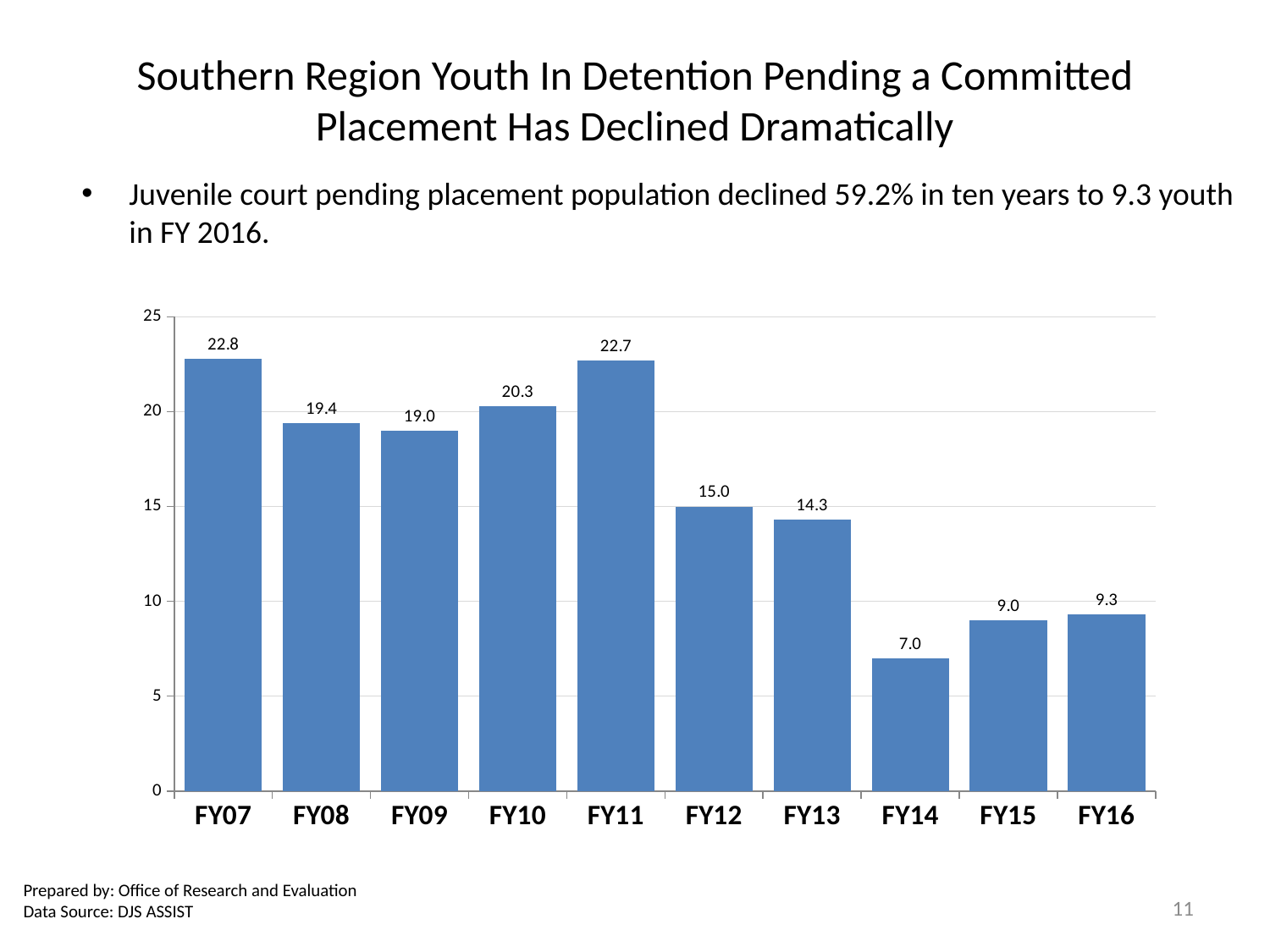
Is the value for FY13 greater or less than 15? less What is the difference between the values for FY11 and FY12? 7.7 Which fiscal year has the highest value? FY07 Do the values generally rise or fall from FY07 to FY16? fall What is the value for FY07? 22.8 How many fiscal years are shown on the x axis? 10 What is the difference between the values for FY07 and FY16? 13.5 Which fiscal year has the lowest value? FY14 What is the value for FY14? 7.0 What is the value for FY16? 9.3 Which is larger, the value for FY10 or the value for FY09? FY10 What kind of chart is shown on the slide? bar chart